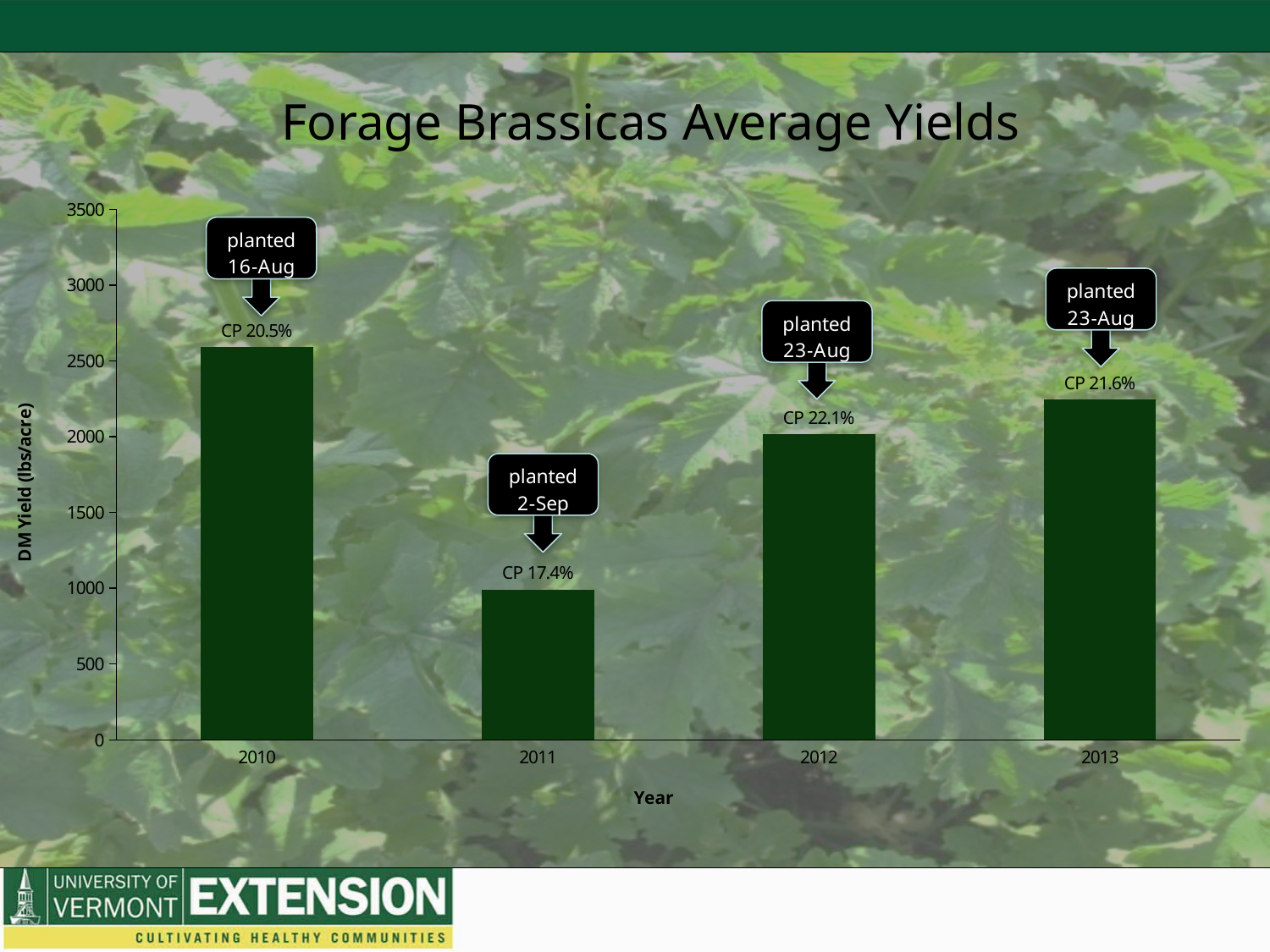
Is the DM yield for 2011 greater or less than 1500 lbs/acre? less Is the DM yield for 2012 greater or less than 2500 lbs/acre? less Which year has the highest DM yield? 2010 Which year has the larger DM yield, 2012 or 2013? 2013 Is the DM yield for 2013 greater or less than 2000 lbs/acre? greater What kind of chart is shown on the slide? bar chart What planting date is shown for 2010? 16-Aug What is the label on the y axis of the chart? DM Yield (lbs/acre) What is the title of the chart? Forage Brassicas Average Yields Which year has the lowest DM yield? 2011 What CP percentage is labelled above the 2011 bar? CP 17.4% How many years are shown on the x axis of the chart? 4